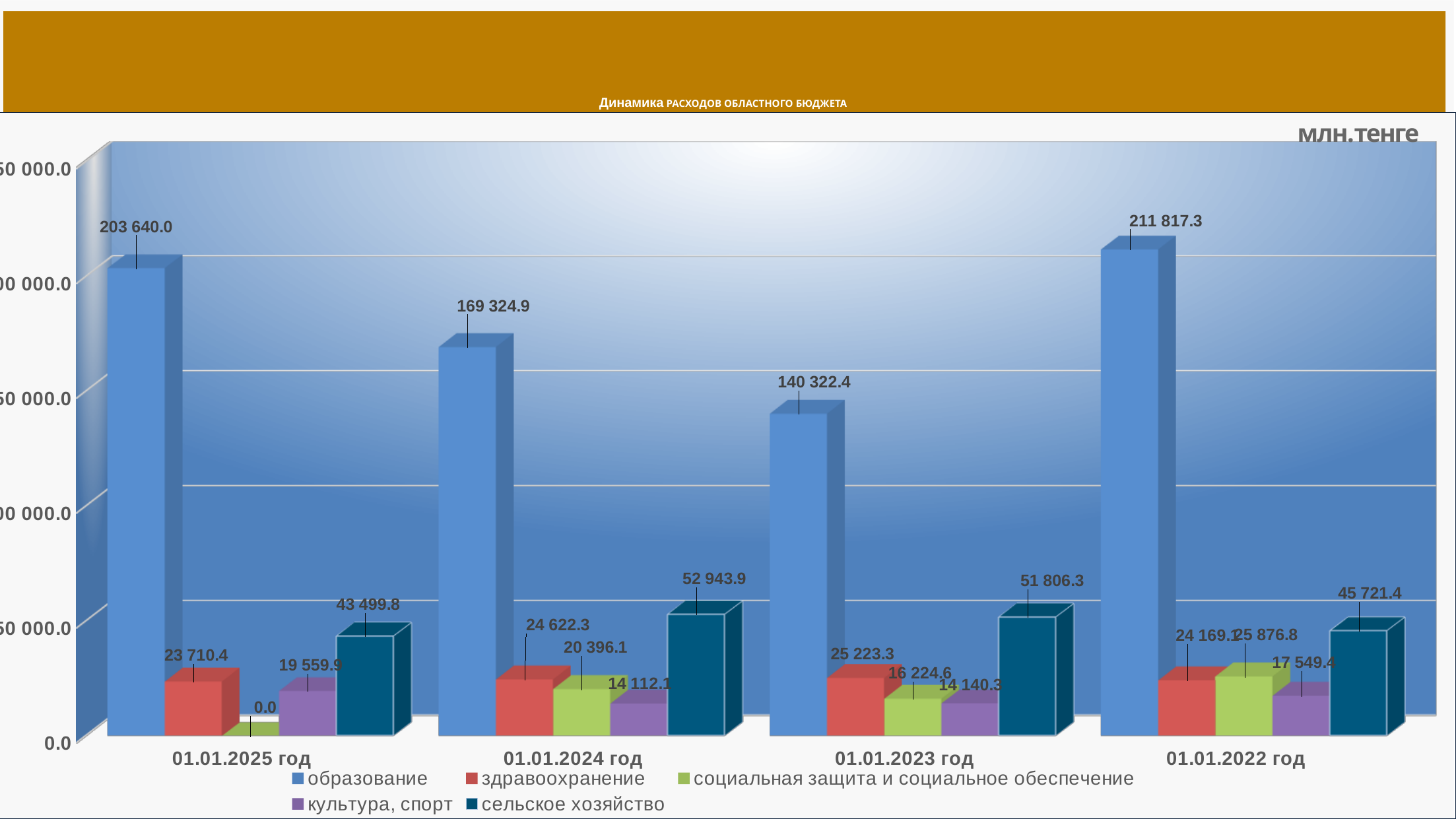
What is the value for сельское хозяйство on 01.01.2024 год? 52 943.9 What unit of measurement is indicated for the chart? млн.тенге What is the value for образование on 01.01.2025 год? 203 640.0 What is the difference between the здравоохранение values on 01.01.2023 год and 01.01.2024 год? 601.0 On which date is the value for образование the highest? 01.01.2022 год What is the difference between the образование values on 01.01.2022 год and 01.01.2025 год? 8 177.3 What kind of chart is shown on the slide? bar chart What is the value for социальная защита и социальное обеспечение on 01.01.2025 год? 0.0 On which date is the value for образование the lowest? 01.01.2023 год How many dates (categories) are shown on the x axis? 4 How many series does the legend list? 5 Which is larger: сельское хозяйство on 01.01.2024 год or on 01.01.2023 год? 01.01.2024 год